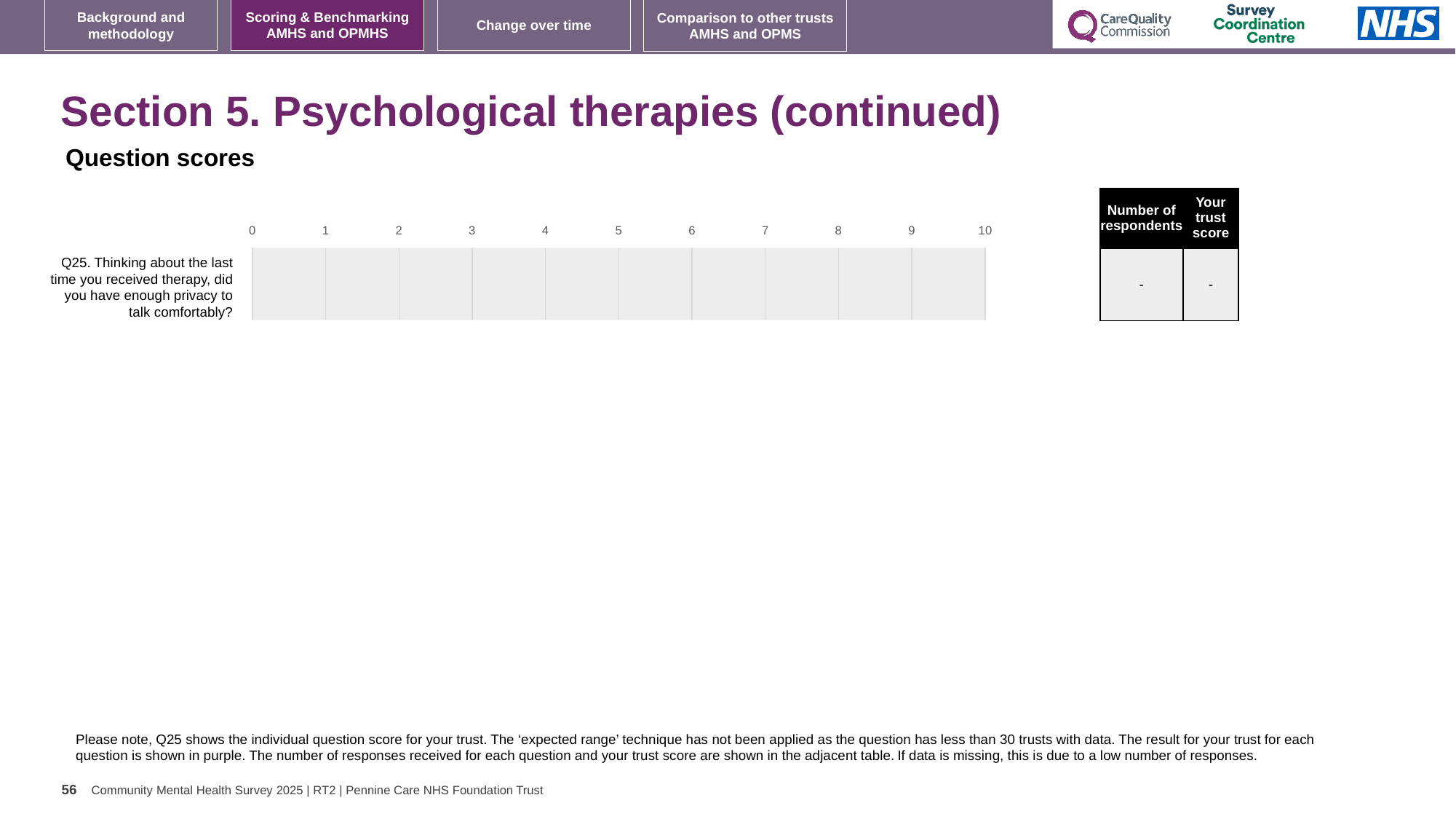
How many questions (categories) are listed on the chart's vertical axis? 1 What kind of chart is shown under 'Question scores'? bar chart What value is shown in the 'Your trust score' column for Q25? - What value is shown in the 'Number of respondents' column for Q25? - Which question number is the single category on the chart? Q25 What is the highest value shown on the chart's horizontal axis? 10